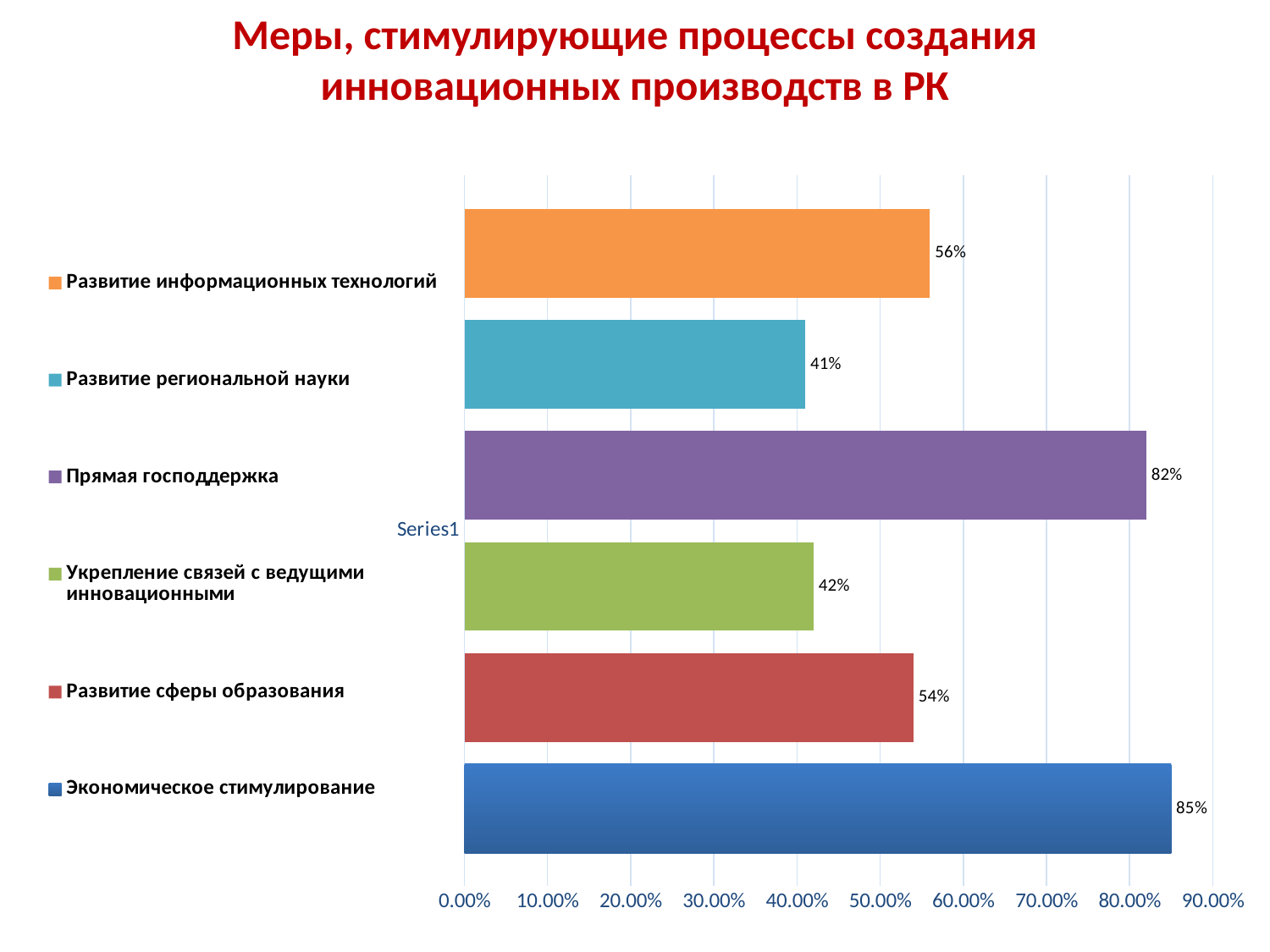
What is the value for Развитие сферы образования? 54% Which is larger, the value for Развитие информационных технологий or the value for Развитие сферы образования? Развитие информационных технологий Which category has the highest value? Экономическое стимулирование What kind of chart is shown on the slide? Bar chart How many categories are shown in the chart? 6 What is the value for Прямая господдержка? 82% What is the title of the chart? Меры, стимулирующие процессы создания инновационных производств в РК What is the difference between the values for Экономическое стимулирование and Развитие сферы образования? 31% What colour is the bar for Прямая господдержка? Purple Which category has the lowest value? Развитие региональной науки What is the value for Экономическое стимулирование? 85% What is the value for Развитие региональной науки? 41%